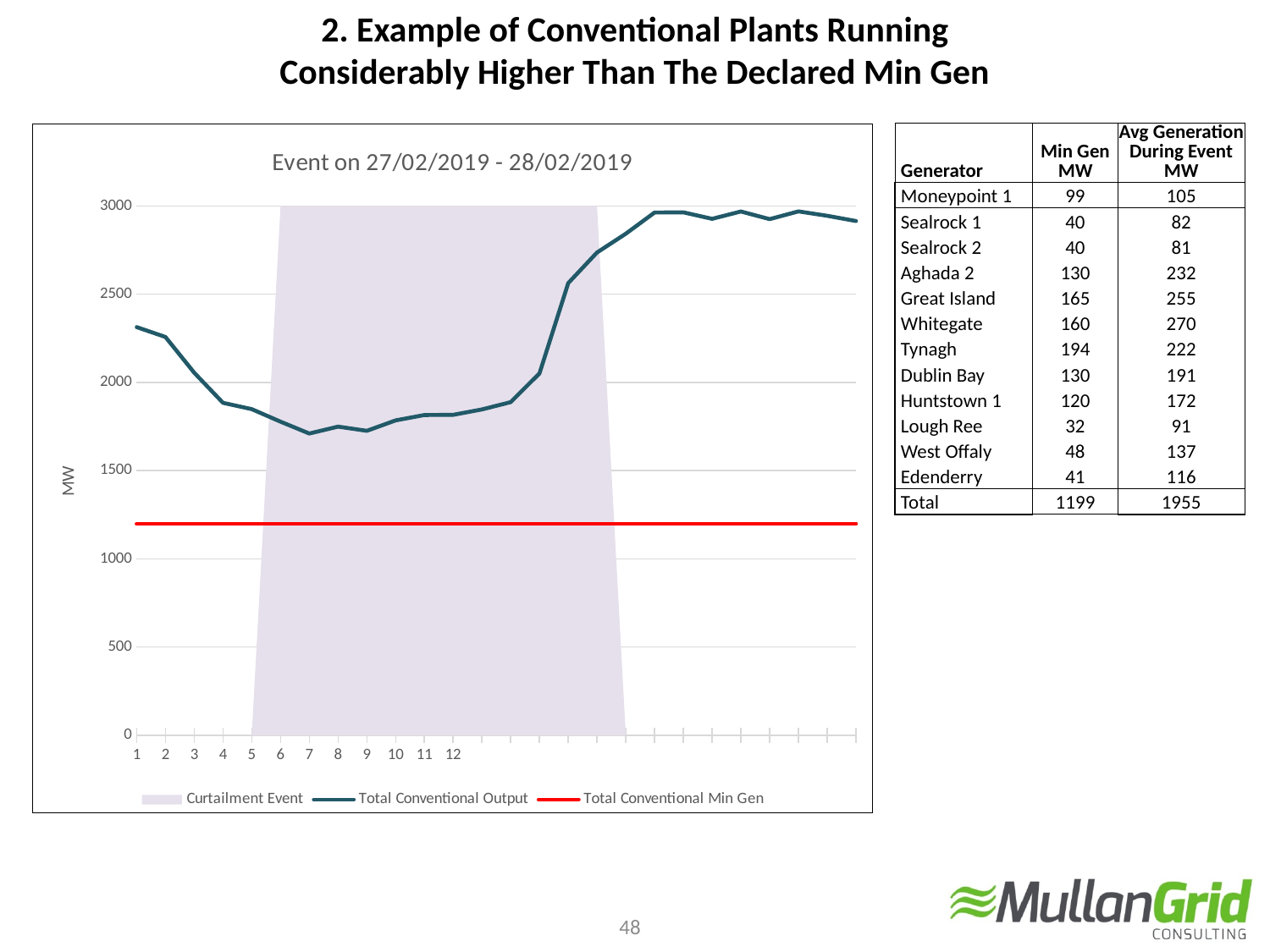
Which is larger, the Total Conventional Output at point 1 or at point 7? point 1 Is the Total Conventional Min Gen line greater or less than 1000? greater Is the Total Conventional Output value at point 7 greater or less than 2000? less What kind of chart is shown on the slide? combination area and line chart Is the Total Conventional Output value at point 1 greater or less than 2000? greater How many series does the chart legend list? 3 What is the title of the chart? Event on 27/02/2019 - 28/02/2019 Which is larger at point 9, the Total Conventional Output or the Total Conventional Min Gen? Total Conventional Output Does the Total Conventional Output rise or fall from point 1 to point 7? fall What label is shown on the chart's vertical axis? MW